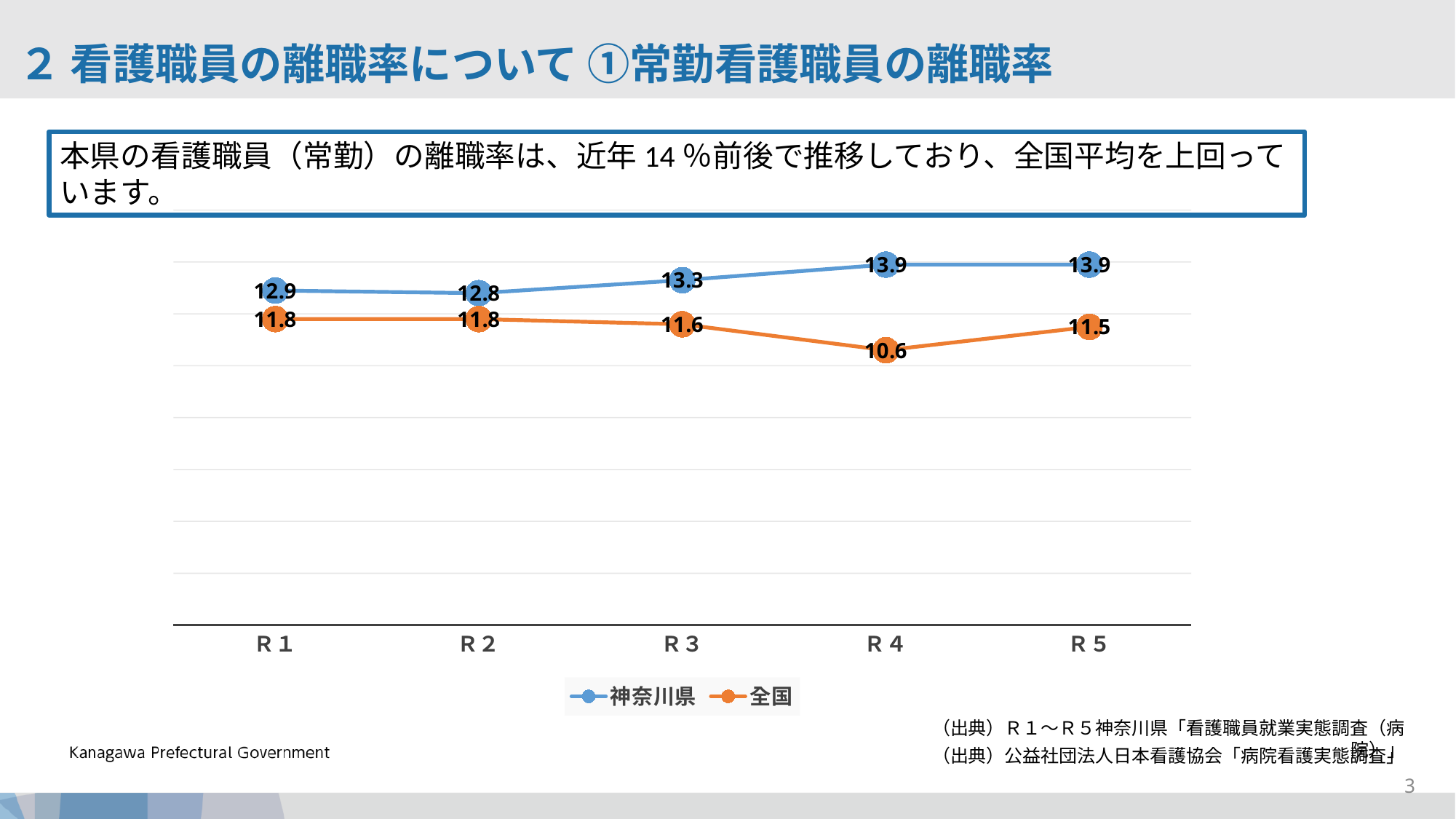
Which series has the larger value in R2, 神奈川県 or 全国? 神奈川県 What is the value for 神奈川県 in R3? 13.3 What is the difference between the 神奈川県 values in R1 and R5? 1.0 In which year is the value for 全国 lowest? R4 In which year is the value for 神奈川県 lowest? R2 What is the difference between 神奈川県 and 全国 in R4? 3.3 What kind of chart is shown on the slide? line chart How many series does the legend list? 2 What is the value for 神奈川県 in R1? 12.9 What is the value for 全国 in R5? 11.5 How many years are shown on the x axis? 5 What is the value for 全国 in R4? 10.6